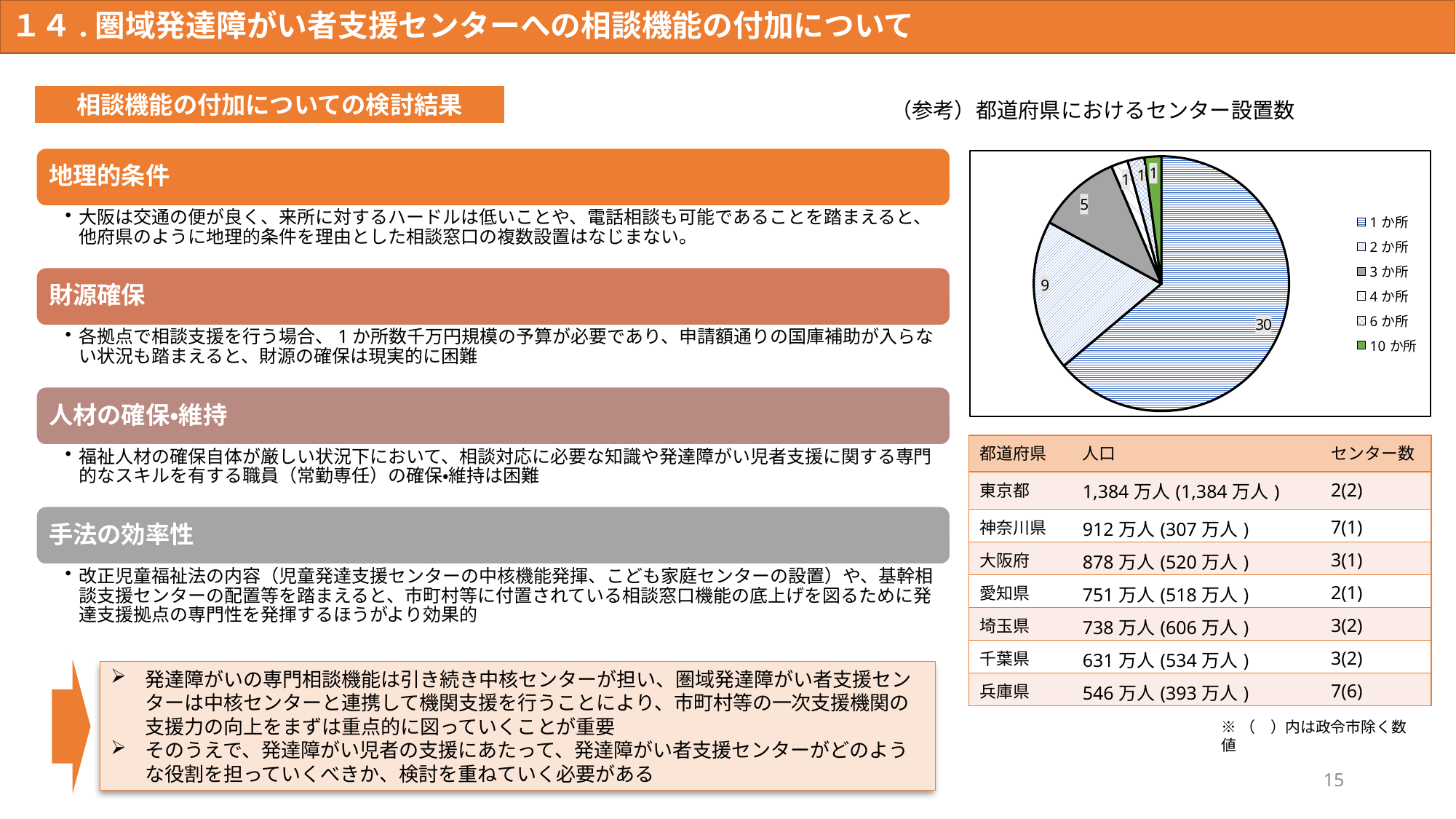
In the pie chart, what is the value for the 3 か所 slice? 5 What is the total of all the values shown in the pie chart? 47 In the pie chart, what is the value for the 2 か所 slice? 9 In the pie chart, which is larger, the 2 か所 slice or the 3 か所 slice? 2 か所 What kind of chart is shown under the heading （参考）都道府県におけるセンター設置数? pie chart Which category has the largest slice in the pie chart? 1 か所 Which legend entry in the pie chart is shown in green? 10 か所 In the pie chart, how many prefectures have 1 か所 (one center)? 30 In the pie chart, what is the difference between the 3 か所 value and the 4 か所 value? 4 In the pie chart, what is the difference between the 1 か所 value and the 2 か所 value? 21 How many categories does the legend of the pie chart list? 6 In the pie chart, what is the value for the 10 か所 slice? 1